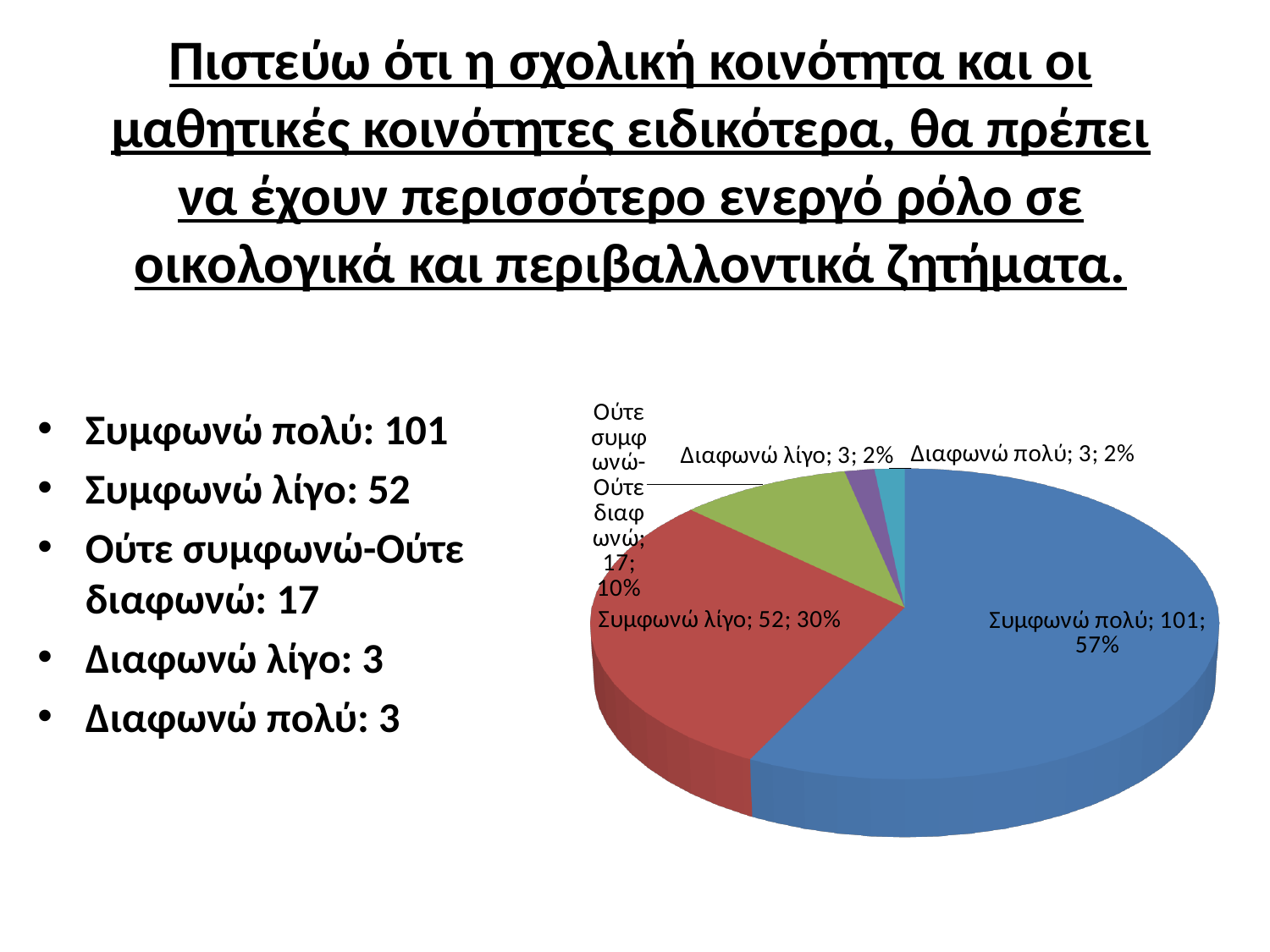
What share of the pie does Συμφωνώ λίγο represent? 30% What is the value for Διαφωνώ πολύ in the pie chart? 3 What share of the pie does Συμφωνώ πολύ represent? 57% Which category has the largest slice in the pie chart? Συμφωνώ πολύ What kind of chart is shown on the slide? pie chart What is the value for Συμφωνώ λίγο in the pie chart? 52 Which is larger, the value for Συμφωνώ λίγο or the value for Ούτε συμφωνώ-Ούτε διαφωνώ? Συμφωνώ λίγο What is the difference between the values for Συμφωνώ πολύ and Συμφωνώ λίγο? 49 What colour is the Συμφωνώ πολύ slice in the pie chart? blue What is the value for Ούτε συμφωνώ-Ούτε διαφωνώ in the pie chart? 17 What is the value for Συμφωνώ πολύ in the pie chart? 101 How many slices does the pie chart have? 5